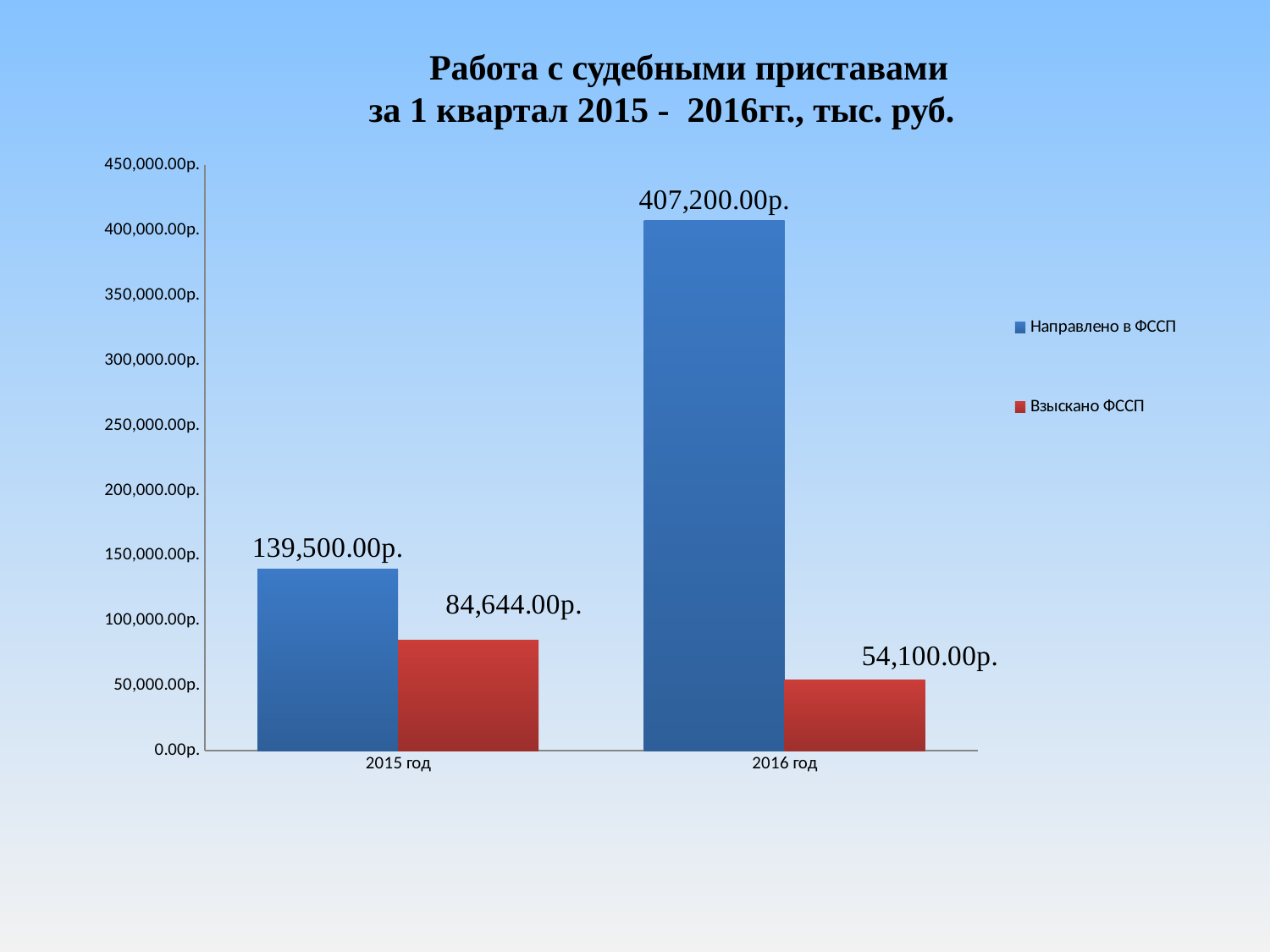
What is the difference between "Направлено в ФССП" and "Взыскано ФССП" in 2016 год? 353,100.00р. Which year has the lowest value for "Взыскано ФССП"? 2016 год Which year has the highest value for "Направлено в ФССП"? 2016 год What is the value for "Взыскано ФССП" in 2016 год? 54,100.00р. What is the value for "Направлено в ФССП" in 2016 год? 407,200.00р. Which is larger: "Взыскано ФССП" in 2015 год or "Взыскано ФССП" in 2016 год? 2015 год What kind of chart is shown on the slide? Bar chart What is the value for "Направлено в ФССП" in 2015 год? 139,500.00р. How many categories are shown on the x axis? 2 How many series does the legend list? 2 What colour are the bars for "Взыскано ФССП"? Red What is the value for "Взыскано ФССП" in 2015 год? 84,644.00р.